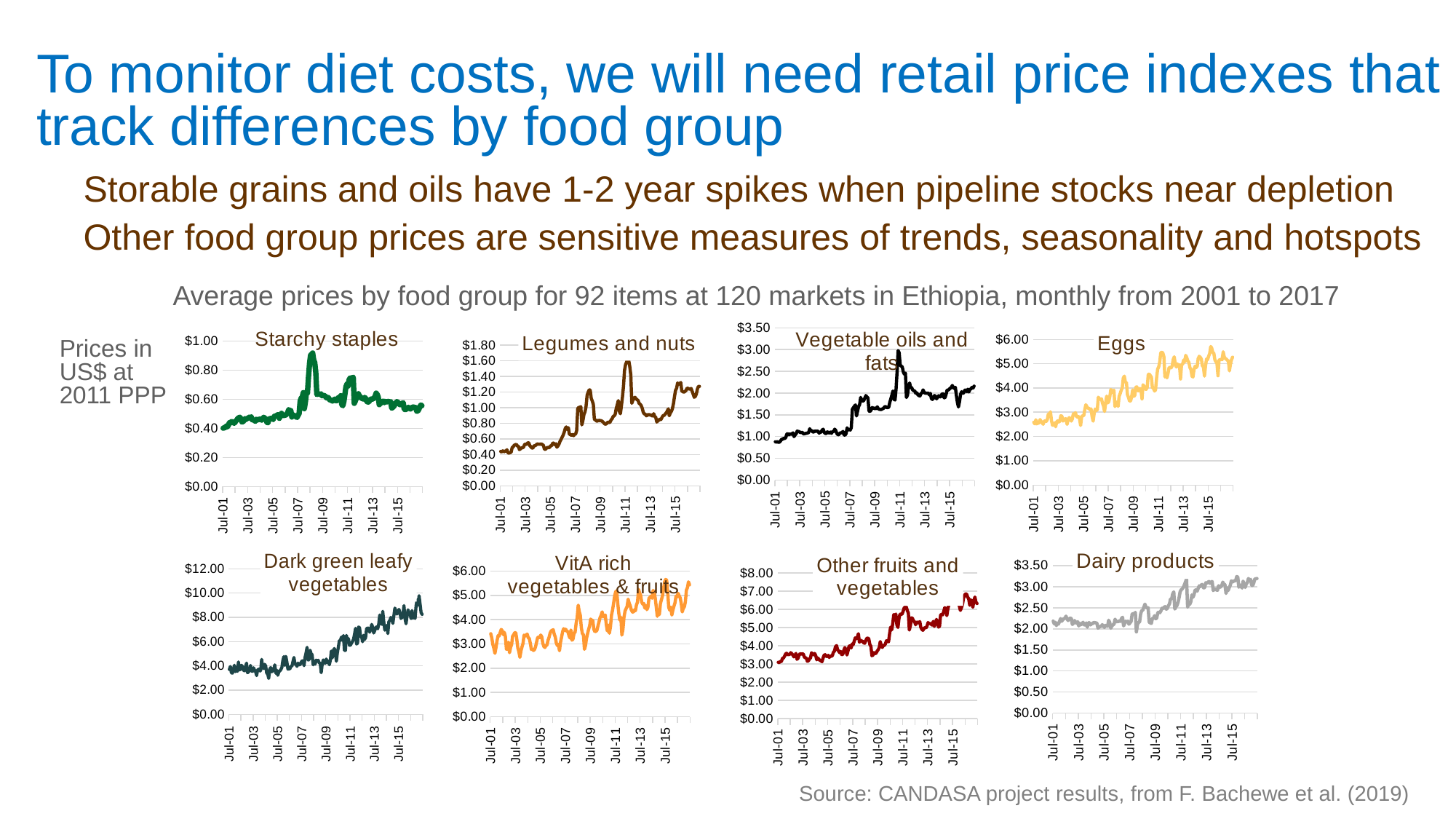
What is the title of the chart drawn with an orange line? VitA rich vegetables & fruits In the 'Dark green leafy vegetables' chart, is the value at Jul-01 greater or less than $6.00? less In the 'Eggs' chart, do the values generally rise or fall from Jul-01 to Jul-15? rise In the 'Starchy staples' chart, is the peak value around Jul-09 greater or less than $0.80? greater In the 'Other fruits and vegetables' chart, is the value at Jul-15 greater or less than $5.00? greater In the 'Dairy products' chart, do the values generally rise or fall from Jul-01 to Jul-15? rise What is the highest value shown on the y axis of the 'Dark green leafy vegetables' chart? $12.00 How many charts are shown on the slide? 8 What kind of chart is the 'Eggs' chart? line chart